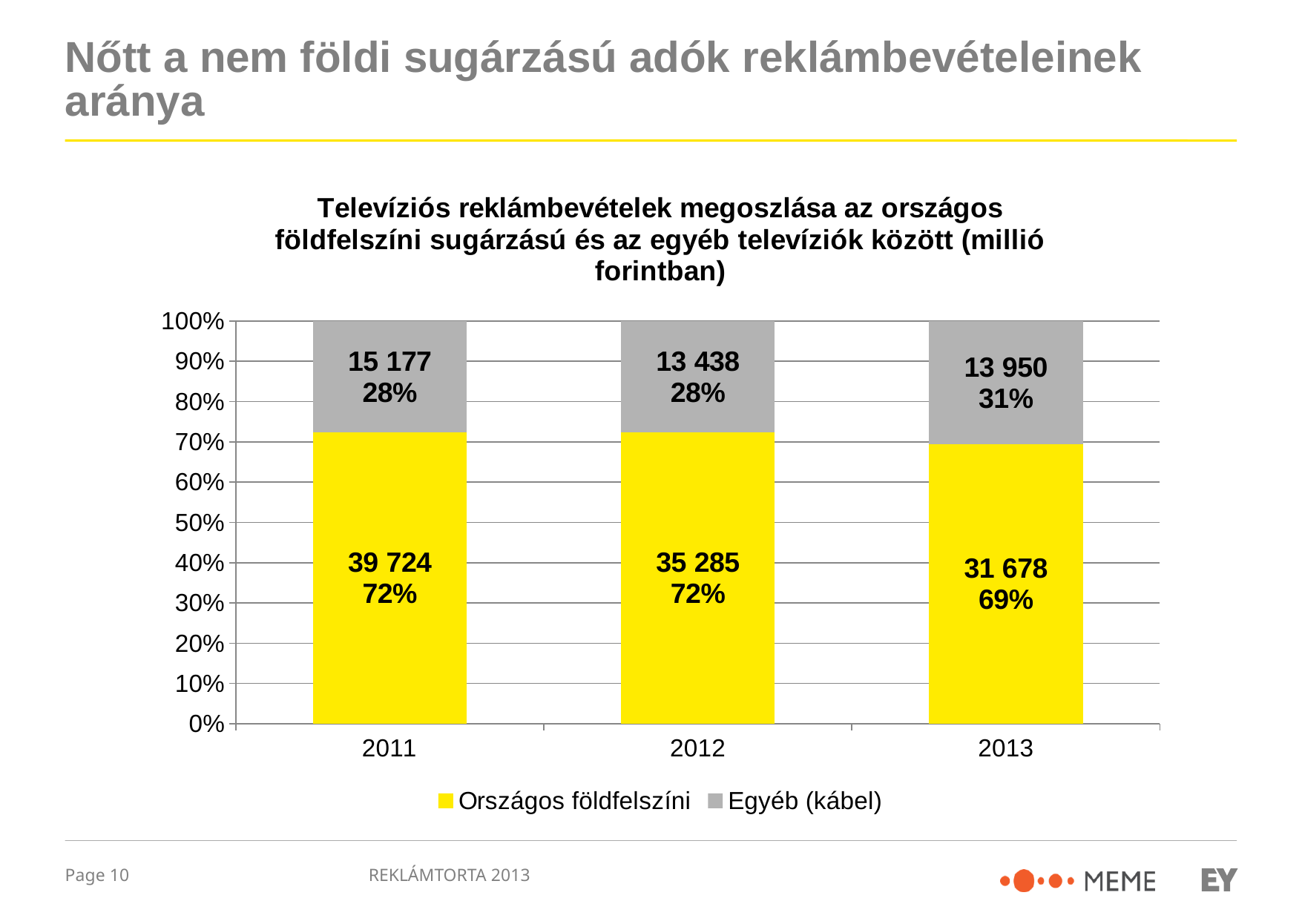
What percentage share does Országos földfelszíni have in 2012? 72% How many years are shown on the x axis? 3 Does the Országos földfelszíni value rise or fall from 2011 to 2013? fall How many series does the legend list? 2 What is the total of the 2012 bar (Országos földfelszíni plus Egyéb (kábel))? 48 723 In which year is the Országos földfelszíni value highest? 2011 What is the value for Egyéb (kábel) in 2013? 13 950 In which year is the Egyéb (kábel) value lowest? 2012 What is the difference between the Országos földfelszíni values for 2011 and 2013? 8 046 What is the value for Országos földfelszíni in 2011? 39 724 Which is larger: the Egyéb (kábel) value in 2011 or in 2012? 2011 What percentage share does Egyéb (kábel) have in 2013? 31%